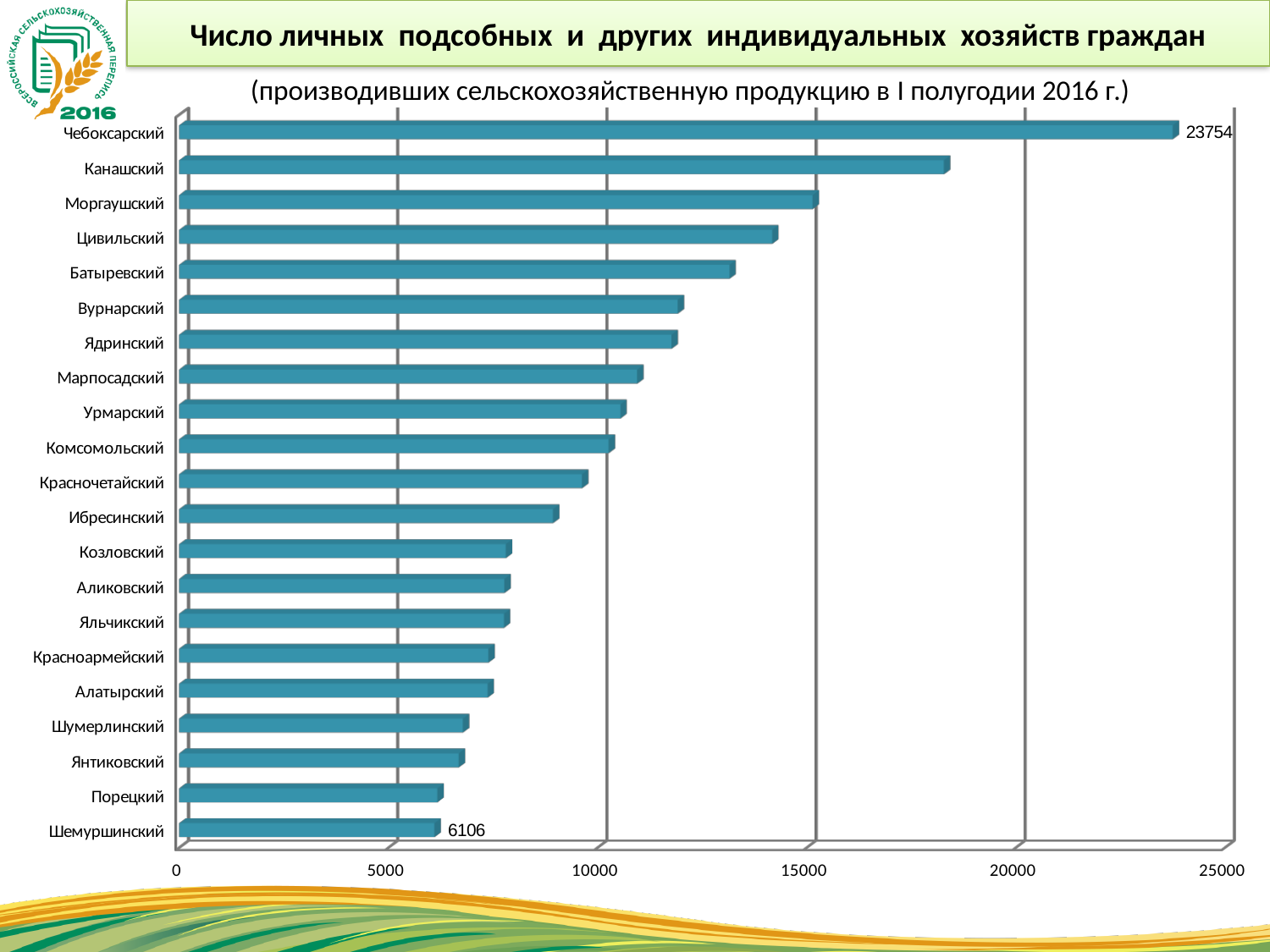
What is the value for Чебоксарский? 23754 What type of chart is shown on the slide? bar chart Which district has the lowest value? Шемуршинский Which district has the highest value? Чебоксарский Is the value for Канашский greater or less than 15000? greater Which has a larger value, Батыревский or Марпосадский? Батыревский Is the value for Цивильский greater or less than 15000? less How many districts are shown in the chart? 21 What is the value for Шемуршинский? 6106 Is the value for Ибресинский greater or less than 10000? less Which has a larger value, Канашский or Моргаушский? Канашский What is the difference between the values for Чебоксарский and Шемуршинский? 17648